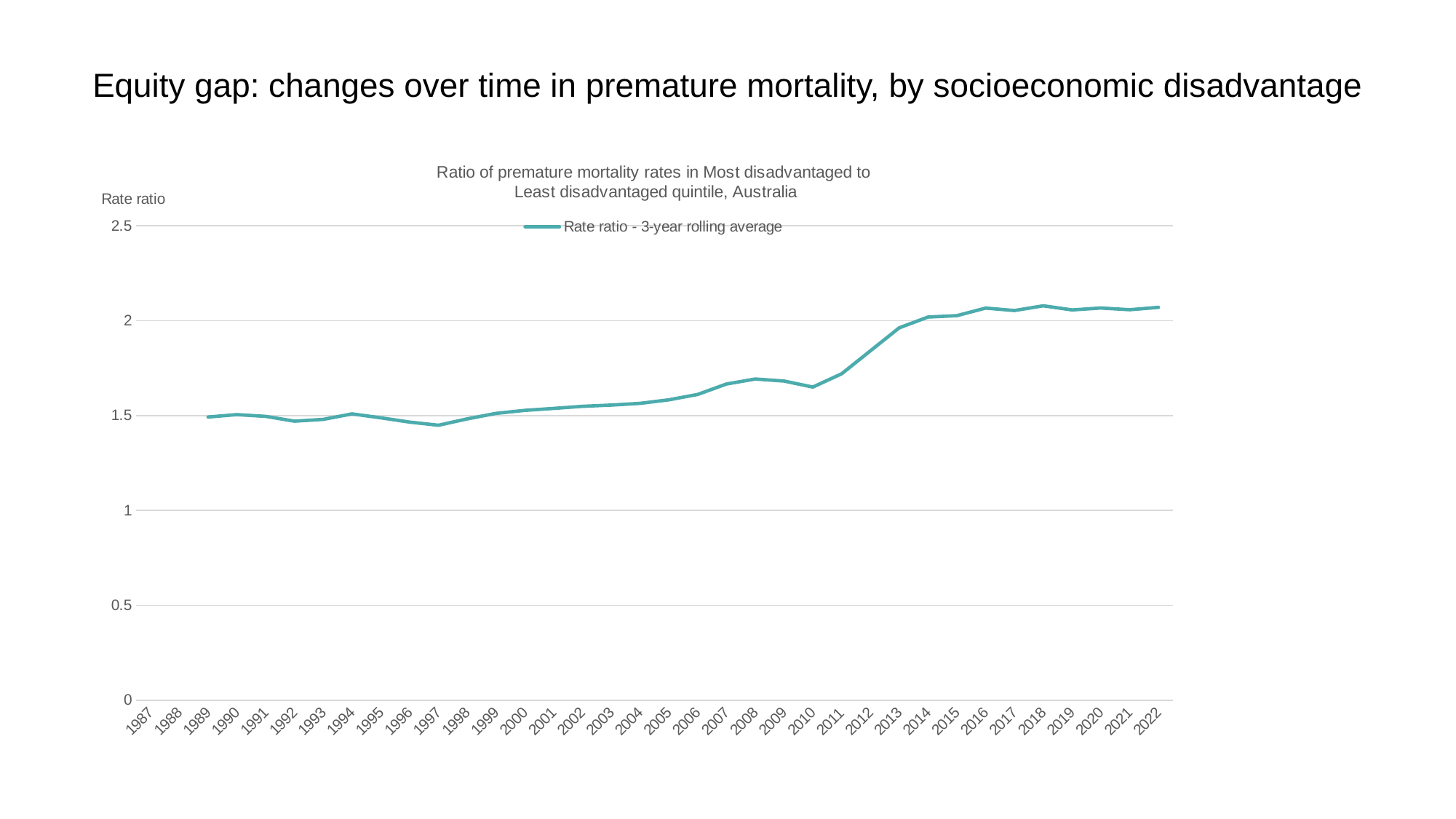
Overall, does the rate ratio rise or fall from 1989 to 2022? Rise Is the rate ratio for 2008 greater or less than 1.5? greater What is the title of the chart? Ratio of premature mortality rates in Most disadvantaged to Least disadvantaged quintile, Australia How many series does the legend list? 1 What kind of chart is shown on the slide? Line chart Is the rate ratio for 2010 greater or less than 2? less Is the rate ratio for 2022 greater or less than 2? greater Which year has the larger rate ratio, 1997 or 2007? 2007 Which year has the larger rate ratio, 1989 or 2022? 2022 Which year has the larger rate ratio, 2011 or 2013? 2013 What is the legend entry for the plotted line? Rate ratio - 3-year rolling average